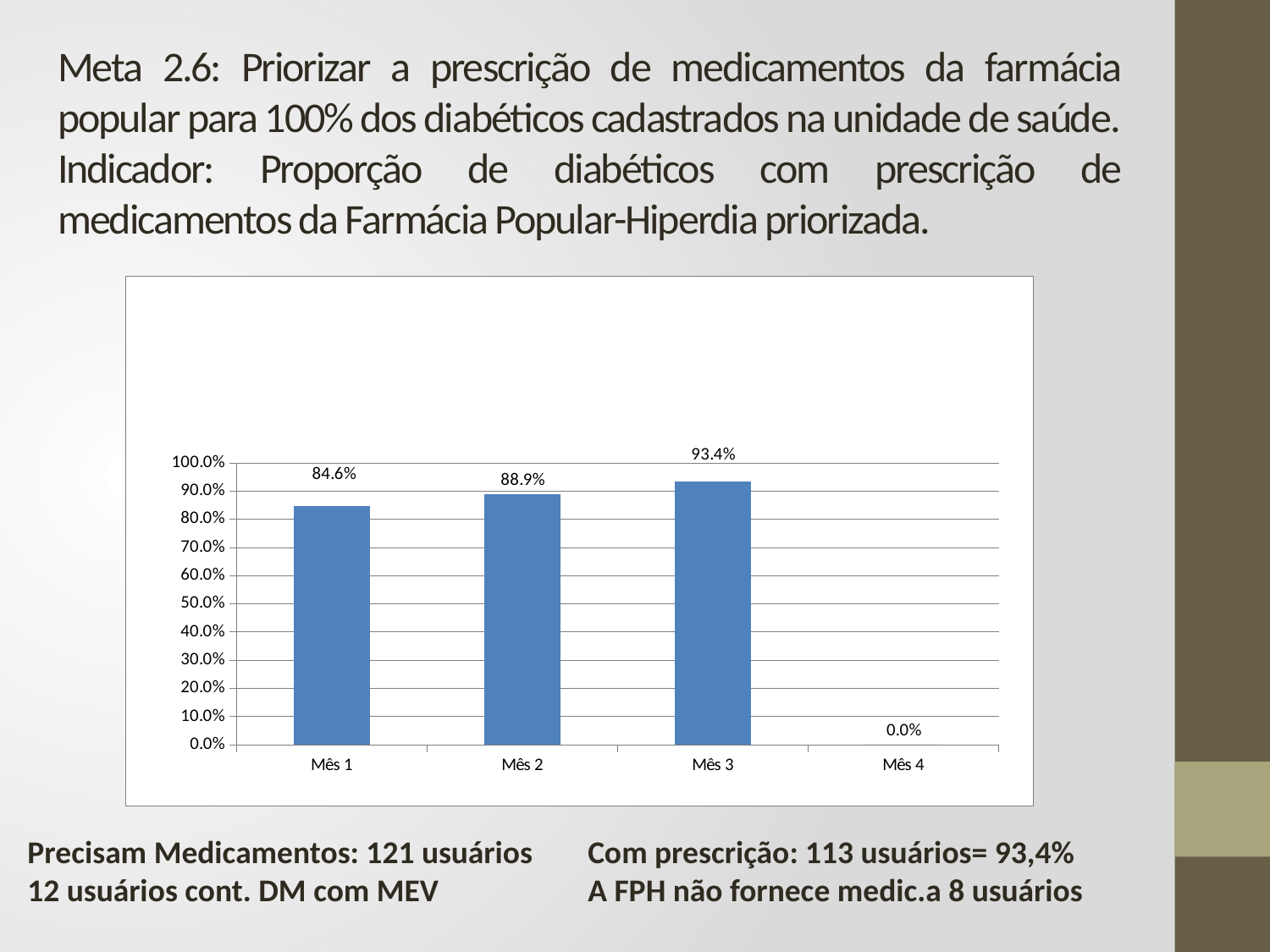
What is the value for Mês 4? 0.0% Which month has the lowest value? Mês 4 What is the value for Mês 3? 93.4% What is the difference between the values for Mês 2 and Mês 1? 4.3% Which is larger, the value for Mês 2 or the value for Mês 3? Mês 3 What is the value for Mês 1? 84.6% What kind of chart is shown on the slide? bar chart What is the value for Mês 2? 88.9% What is the difference between the values for Mês 3 and Mês 1? 8.8% Is the value for Mês 1 greater or less than 80.0%? greater Which month has the highest value? Mês 3 How many categories are shown on the x axis? 4